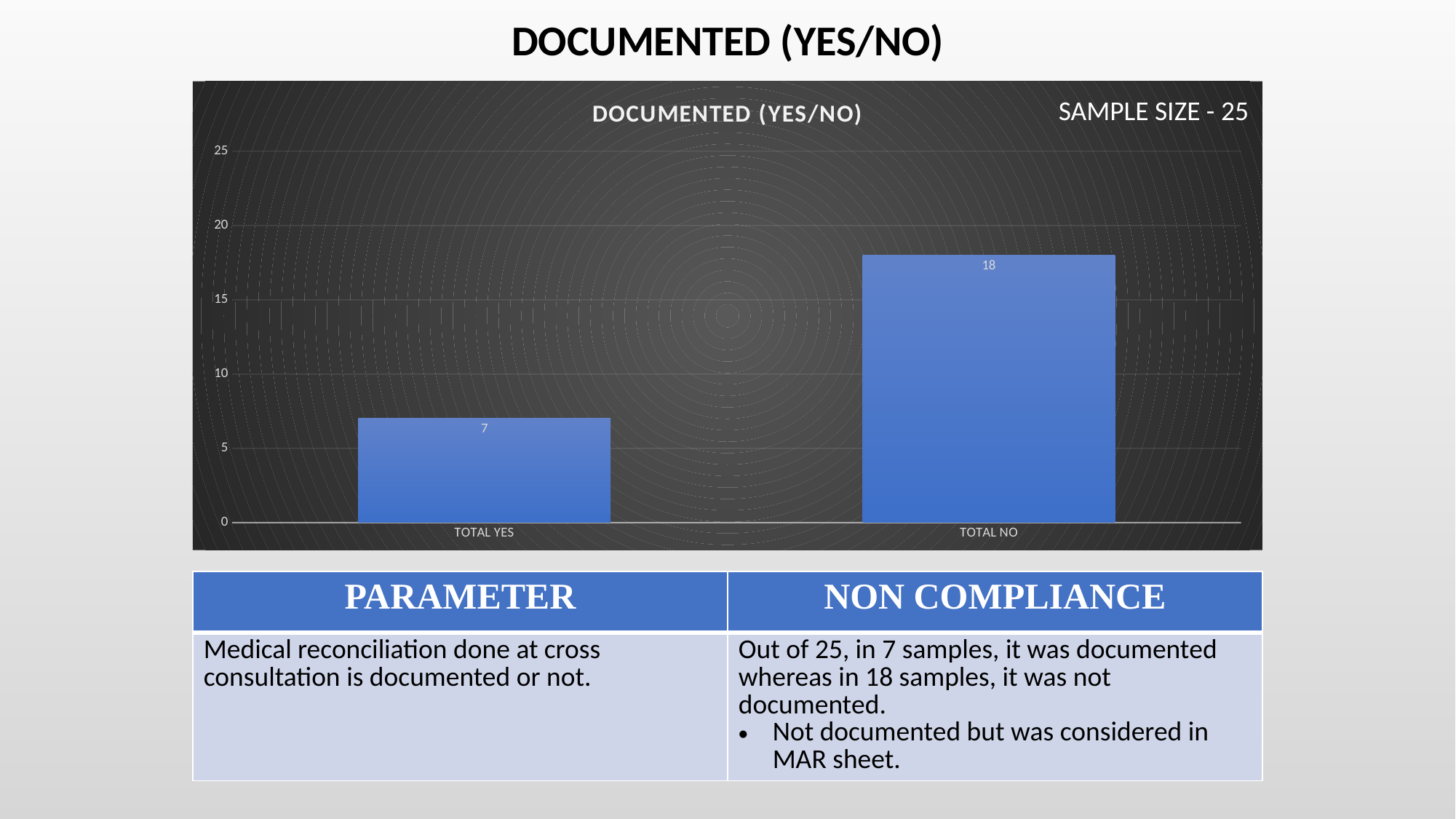
What is the difference between the values for TOTAL NO and TOTAL YES? 11 Is the value for TOTAL NO greater or less than 15? greater What is the title of the chart? DOCUMENTED (YES/NO) What is the highest value shown on the y axis? 25 What kind of chart is shown on the slide? bar chart What is the value for TOTAL YES? 7 What is the value for TOTAL NO? 18 Which category has the lowest value? TOTAL YES Is the value for TOTAL YES greater or less than 10? less How many categories are shown on the x axis? 2 Which category has the highest value? TOTAL NO Which is larger, the value for TOTAL YES or the value for TOTAL NO? TOTAL NO